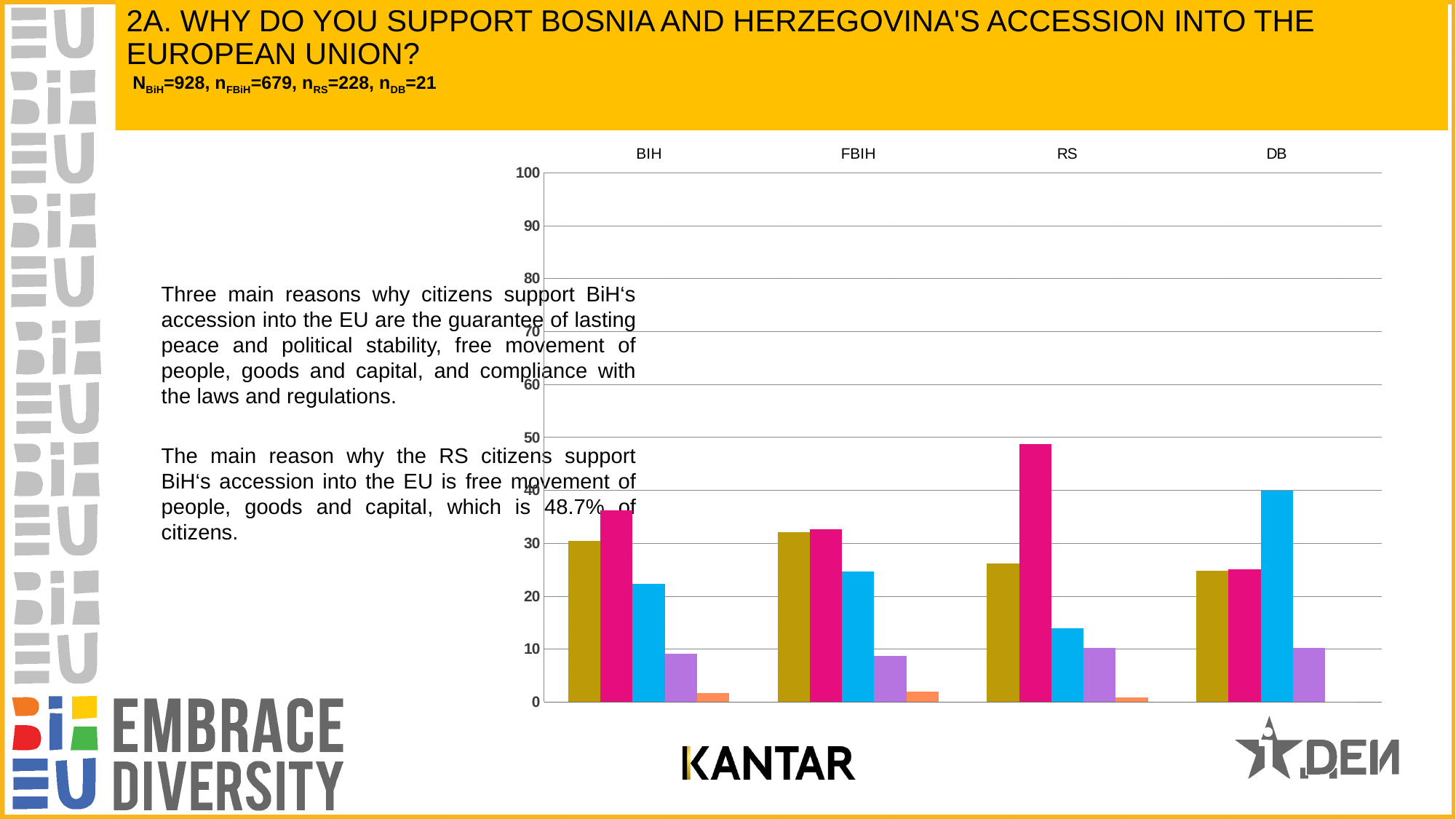
Is the value of the blue bar for RS greater or less than 20? less Which categories are labelled along the top of the chart? BIH, FBIH, RS, DB Is the value of the magenta bar for RS greater or less than 40? greater For DB, which bar is taller: the blue bar or the purple bar? the blue bar Is the value of the gold bar for BIH greater or less than 40? less Which category contains the tallest bar on the chart? RS How many categories are shown along the x axis of the chart? 4 For RS, which bar is taller: the magenta bar or the gold bar? the magenta bar What kind of chart is shown on the slide? bar chart What is the highest value shown on the chart's vertical axis? 100